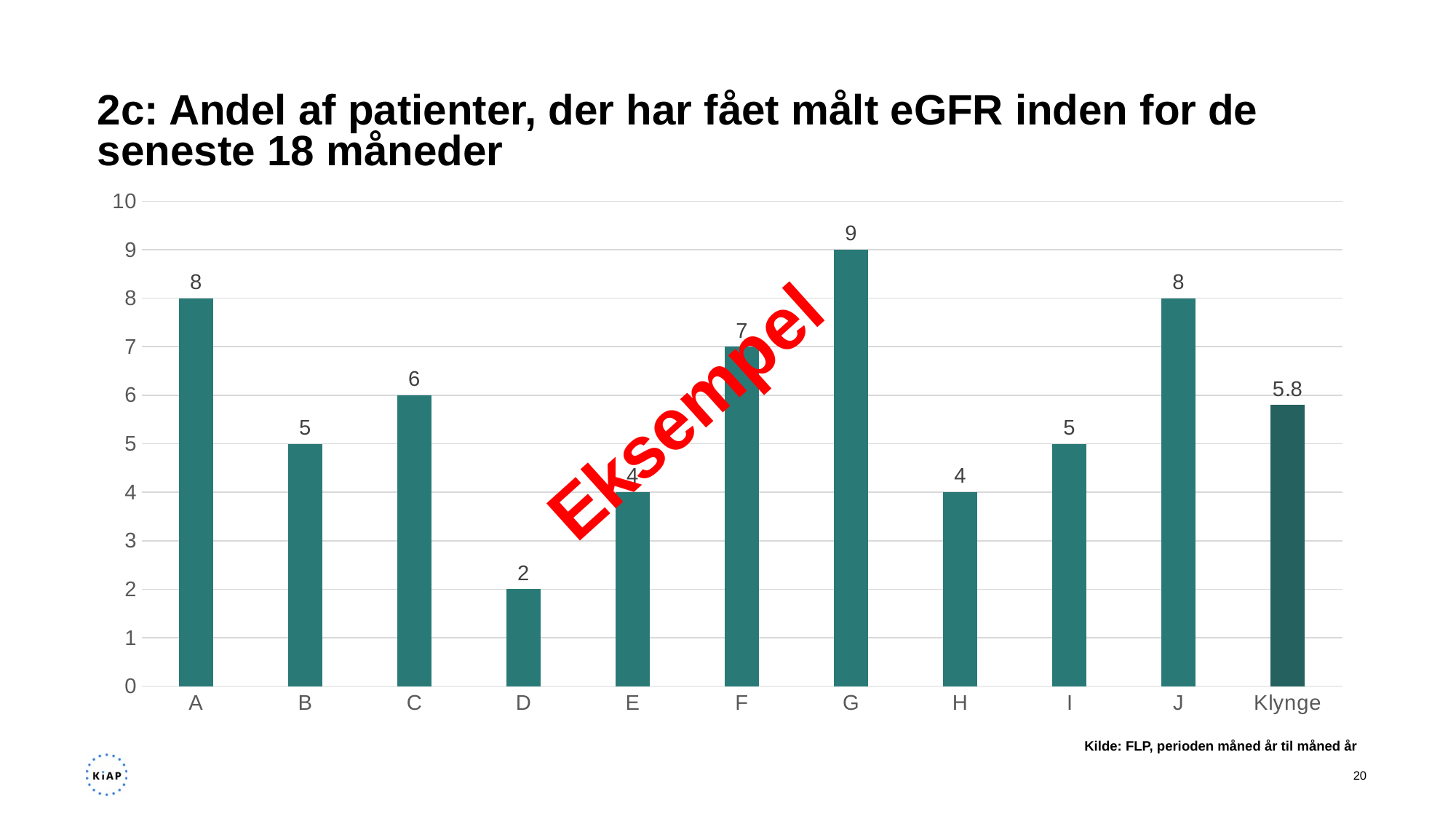
Is the value for F greater or less than 5? greater Which category has the lowest value? D What is the difference between the values for A and B? 3 Which category has the highest value? G What is the value for Klynge? 5.8 Which is larger, the value for C or the value for H? C What is the value for category G? 9 What is the value for category D? 2 What kind of chart is shown on the slide? Bar chart What is the title of the chart? 2c: Andel af patienter, der har fået målt eGFR inden for de seneste 18 måneder How many categories are shown on the x axis? 11 What is the difference between the values for G and D? 7